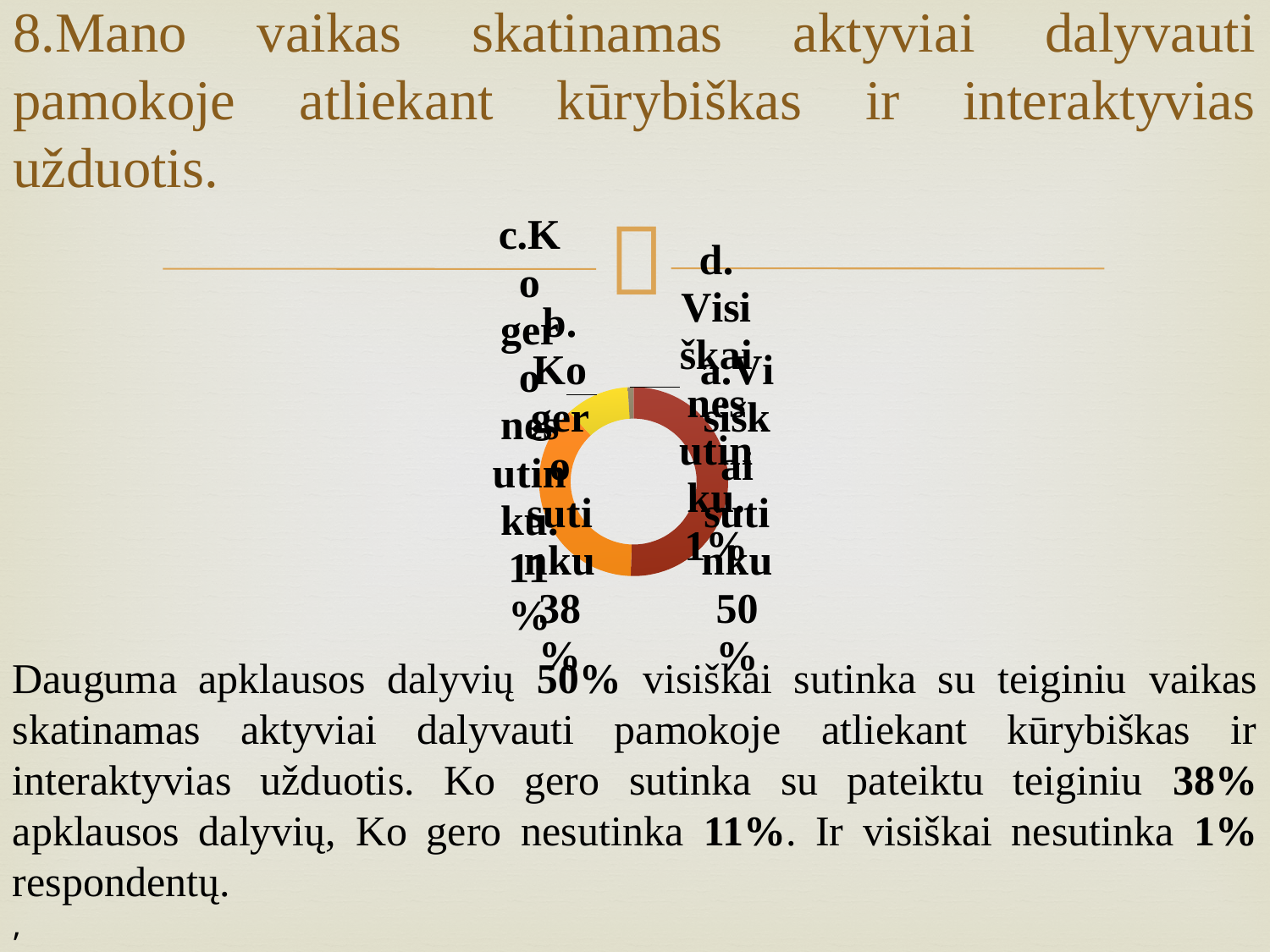
Which answer option has the largest share of the chart? a. Visiškai sutinku What share of respondents answered "d. Visiškai nesutinku"? 1% What kind of chart is shown on the slide? doughnut chart What colour is the segment representing "a. Visiškai sutinku" (50%)? dark red What is the combined share of "c. Ko gero nesutinku" and "d. Visiškai nesutinku"? 12% What share of respondents answered "a. Visiškai sutinku"? 50% What share of respondents answered "c. Ko gero nesutinku"? 11% What share of respondents answered "b. Ko gero sutinku"? 38% Which answer option has the smallest share of the chart? d. Visiškai nesutinku How many percentage points larger is the share for "a. Visiškai sutinku" than for "b. Ko gero sutinku"? 12 Which is larger: the share for "c. Ko gero nesutinku" or for "d. Visiškai nesutinku"? c. Ko gero nesutinku How many answer categories are shown in the chart? 4